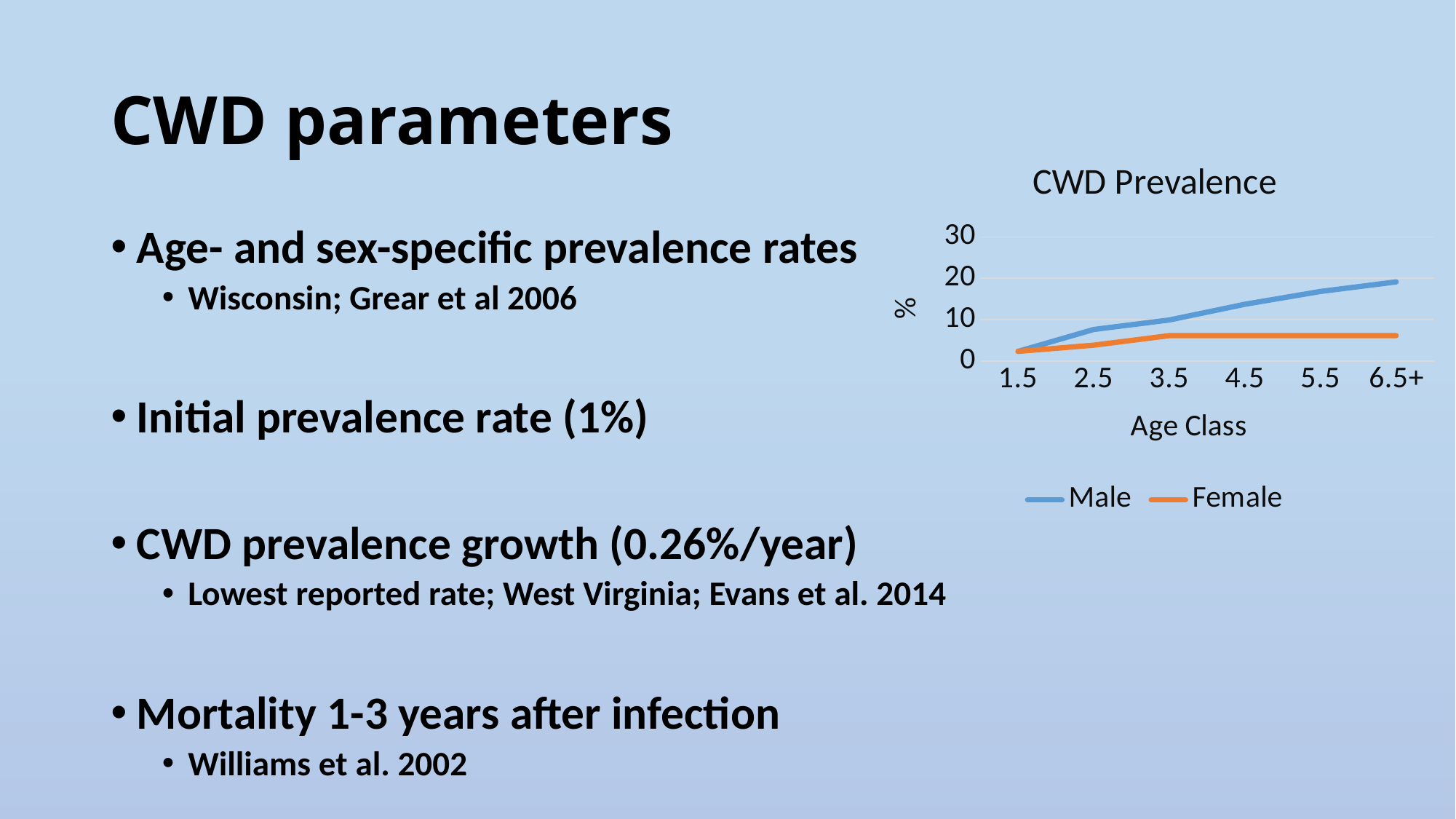
What kind of chart is shown on the slide? line chart Is the Male prevalence at age class 6.5+ greater or less than 10? greater What is the x-axis title of the chart? Age Class How many series does the legend of the CWD Prevalence chart list? 2 At which age class is the Male prevalence highest? 6.5+ Is the Male prevalence at age class 1.5 greater or less than 10? less Is the Female prevalence at age class 6.5+ greater or less than 10? less What is the title of the chart? CWD Prevalence How many age classes are shown on the x axis of the CWD Prevalence chart? 6 Does the Male prevalence rise or fall as age class increases? rise At which age class is the Male prevalence lowest? 1.5 At age class 6.5+, which series has the higher prevalence, Male or Female? Male